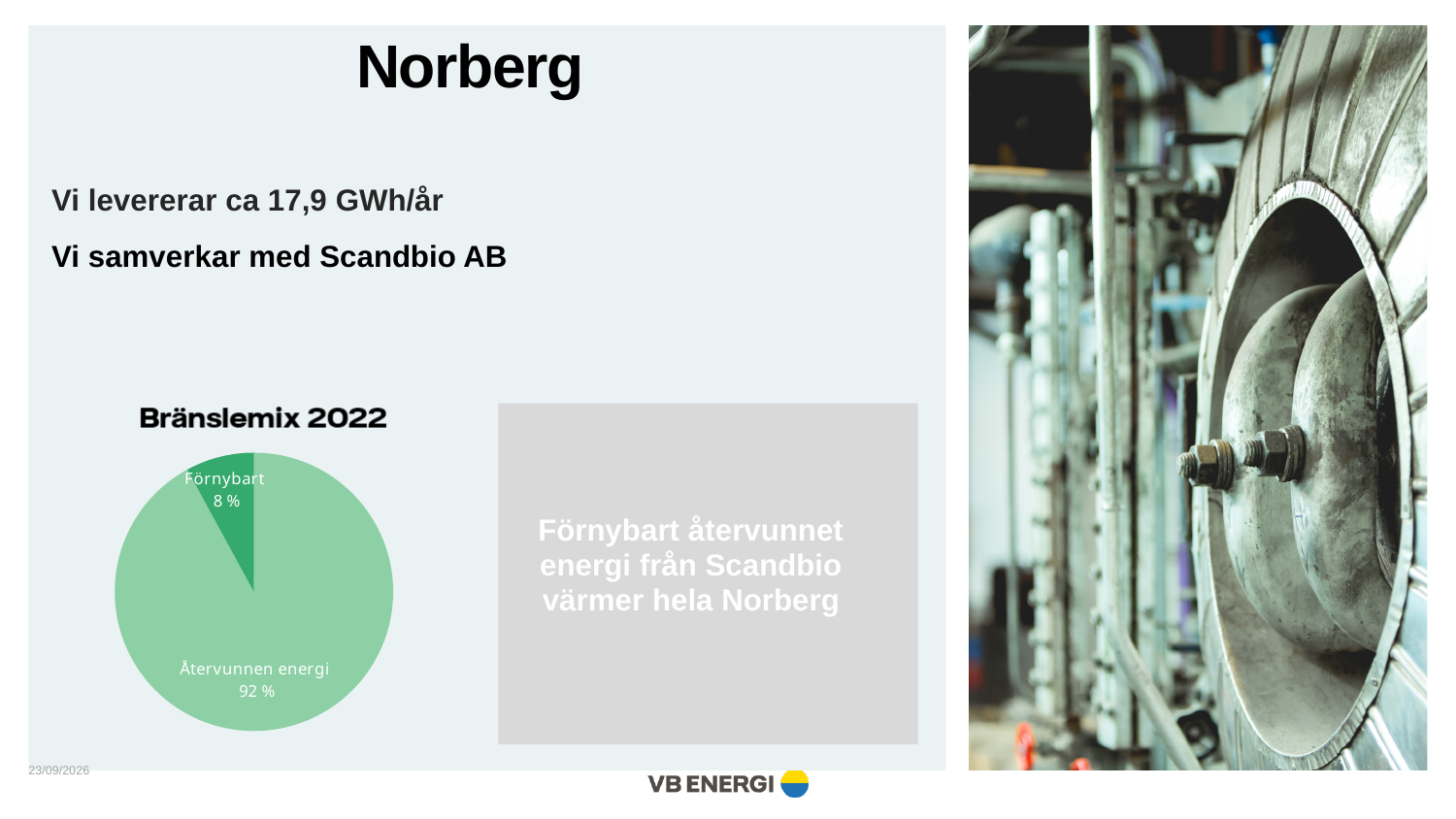
How many slices does the pie chart have? 2 What is the difference in percentage points between the "Återvunnen energi" slice and the "Förnybart" slice? 84 percentage points What share of the pie chart is labelled "Förnybart"? 8 % Which slice of the pie chart is the largest? Återvunnen energi What type of chart is shown under the title "Bränslemix 2022"? Pie chart Which slice of the pie chart is the smallest? Förnybart What is the title of the chart on the slide? Bränslemix 2022 What share of the pie chart is labelled "Återvunnen energi"? 92 % What colour is the "Förnybart" slice compared with the "Återvunnen energi" slice? Darker green Is the share for "Förnybart" greater or less than 10 %? less Which is larger in the pie chart, "Förnybart" or "Återvunnen energi"? Återvunnen energi What is the combined share of the two slices in the pie chart? 100 %